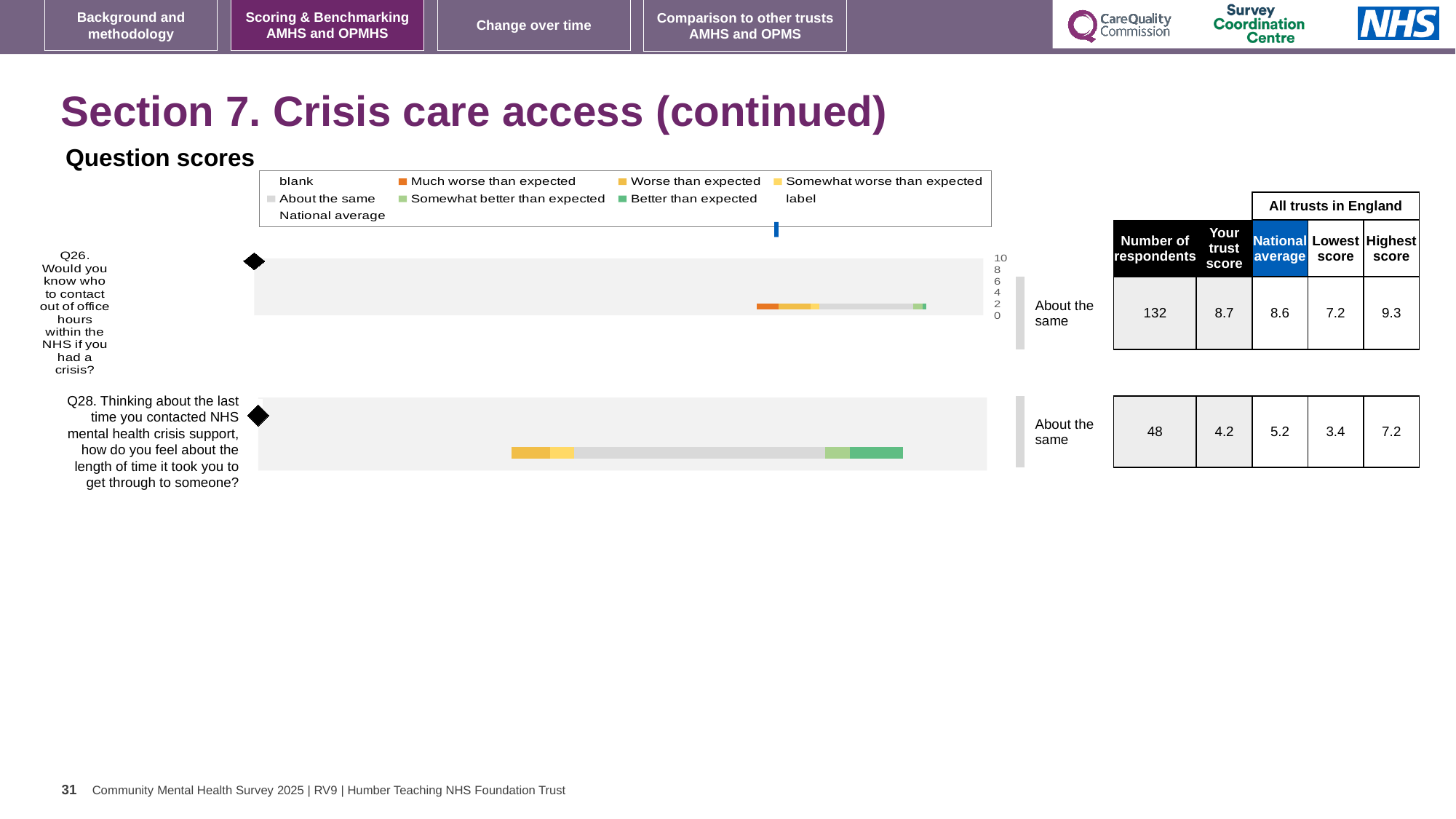
How many respondents answered Q26? 132 What is the highest value shown on the chart's numeric axis? 10 What is the difference between the national average and the trust score for Q28? 1.0 Which question has the higher trust score, Q26 or Q28? Q26 What is the national average score for Q28? 5.2 What kind of chart is used to show the question scores on this slide? bar chart Which legend entry is shown in orange in the question scores chart? Much worse than expected What benchmark category is given for Q28 next to its bar? About the same How many questions (bars) are plotted in the question scores chart? 2 What is the difference between the highest score and the lowest score for Q26 across all trusts in England? 2.1 What is the 'Your trust score' value for Q28 (length of time to get through to crisis support)? 4.2 What is the 'Your trust score' value for Q26 (knowing who to contact out of office hours)? 8.7